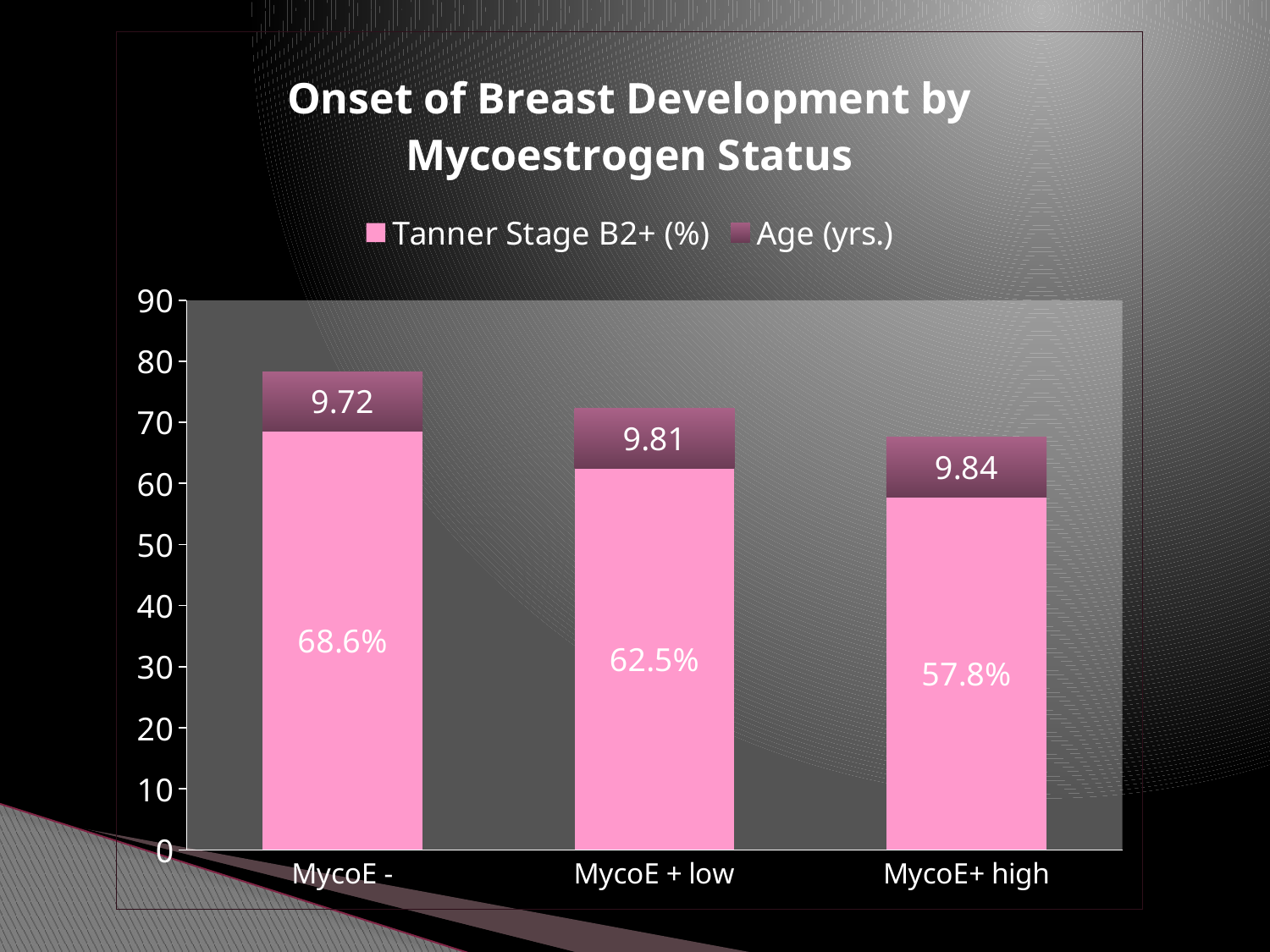
Which has a larger Tanner Stage B2+ (%) value, MycoE + low or MycoE+ high? MycoE + low What is the difference in Tanner Stage B2+ (%) between MycoE - and MycoE + low? 6.1% How many categories are shown on the x axis? 3 Which category has the lowest Age (yrs.) value? MycoE - What is the difference in Age (yrs.) between MycoE+ high and MycoE -? 0.12 What is the Tanner Stage B2+ (%) value for MycoE+ high? 57.8% Which category has the highest Tanner Stage B2+ (%) value? MycoE - How many series does the legend list? 2 Do the Tanner Stage B2+ (%) values rise or fall from MycoE - to MycoE+ high? Fall What is the Tanner Stage B2+ (%) value for MycoE -? 68.6% What is the Age (yrs.) value for MycoE + low? 9.81 What kind of chart is shown on the slide? Stacked bar chart